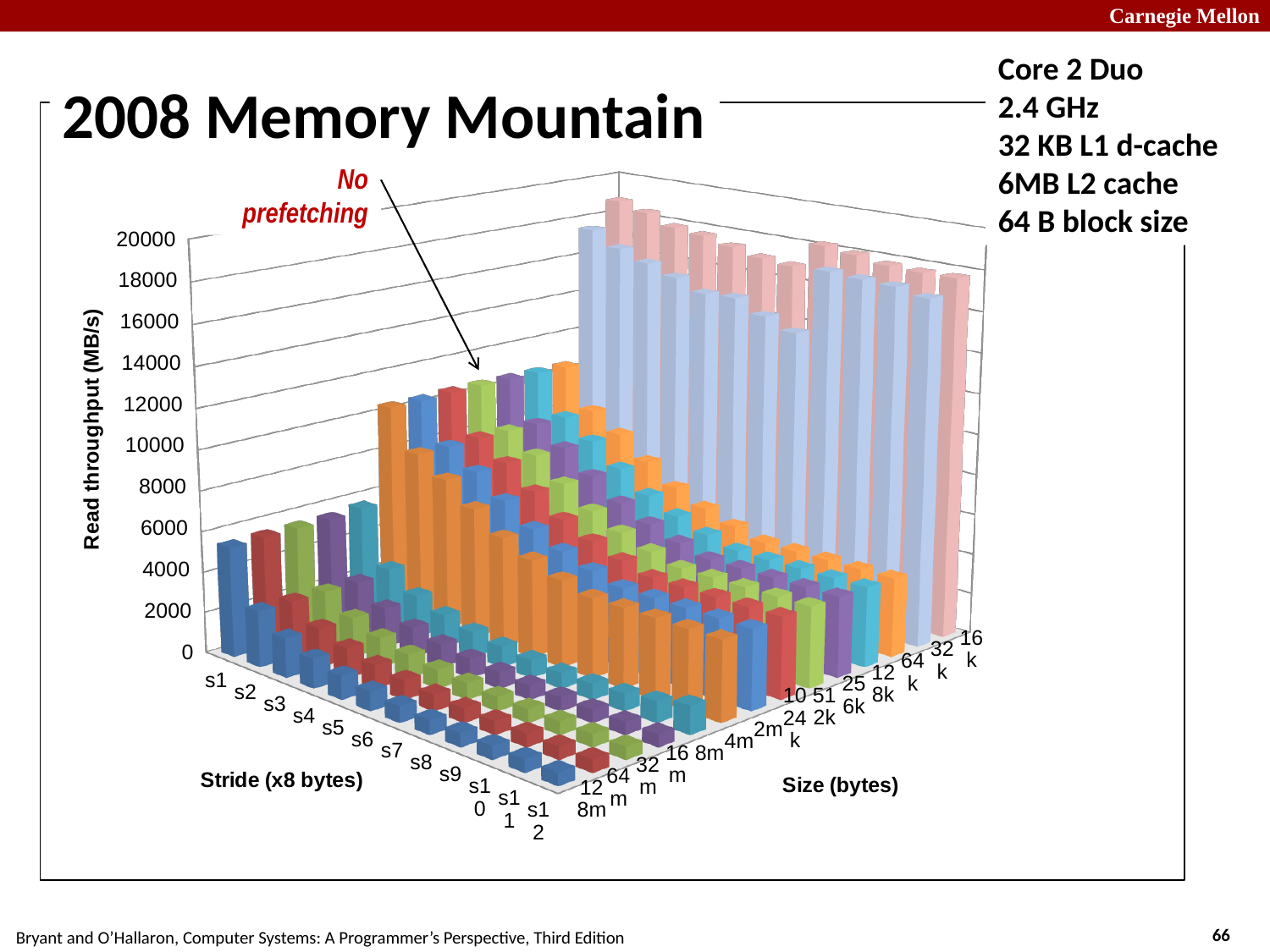
Is the read throughput for stride s12 at size 128m greater or less than 4000? less Is the read throughput for stride s1 at size 16k greater or less than 14000? greater What is the label of the vertical axis? Read throughput (MB/s) For stride s1, does read throughput rise or fall as the size goes from 128m toward 16k? rise What is the highest tick value shown on the read throughput axis? 20000 What kind of chart is shown on the slide? 3D bar chart What is the title of the chart? 2008 Memory Mountain Which is larger: the read throughput for stride s1 at size 16k or at size 128m? 16k Is the read throughput for stride s1 at size 128m greater or less than 10000? less Which is larger: the read throughput for stride s1 at size 8m or for stride s12 at size 8m? s1 How many stride categories are shown along the stride axis? 12